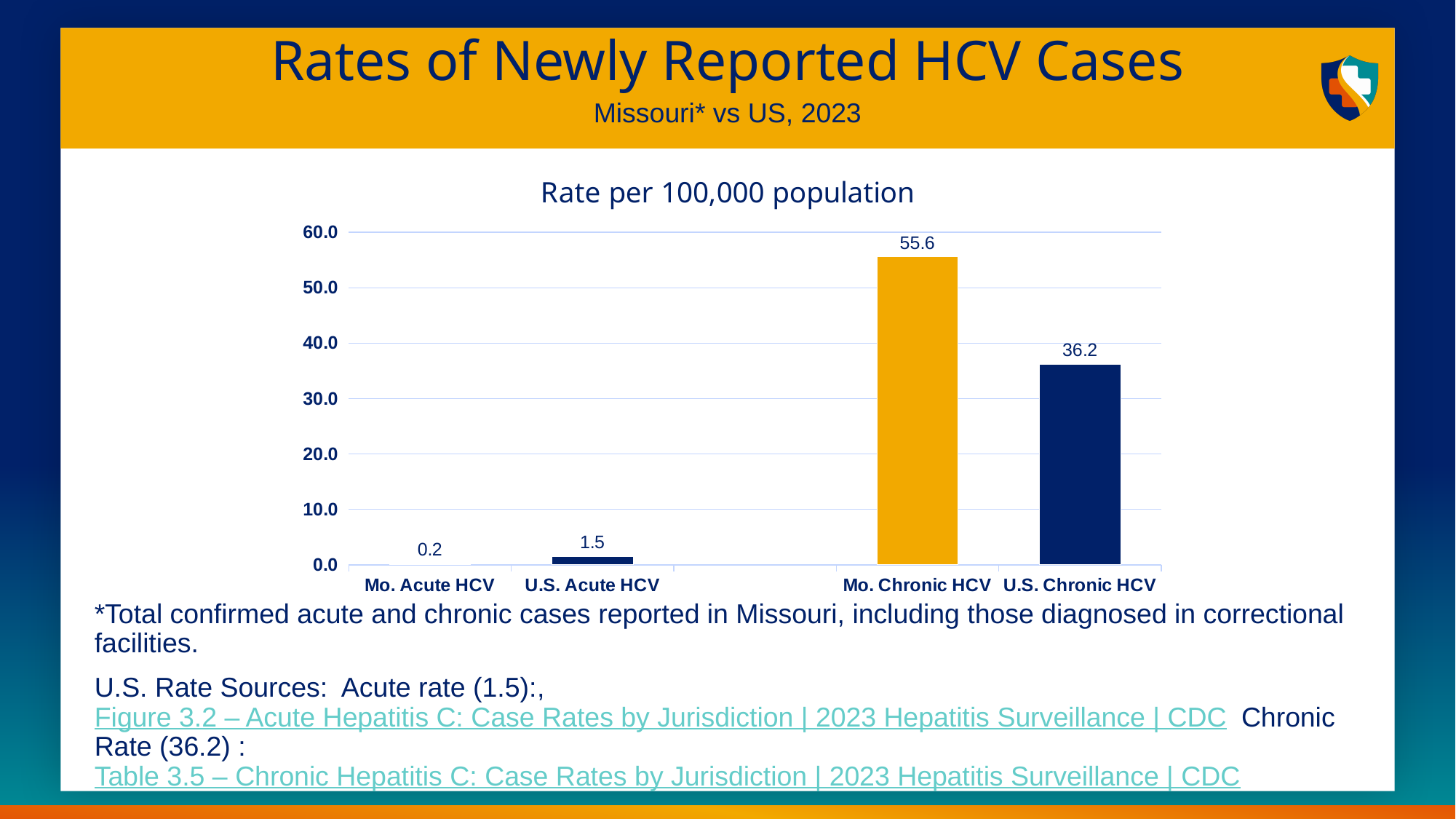
What is the rate for U.S. Acute HCV? 1.5 What kind of chart is shown on the slide? Bar chart What is the difference between the Mo. Chronic HCV rate and the U.S. Chronic HCV rate? 19.4 How many categories are shown on the chart? 4 What is the title of the chart? Rate per 100,000 population Which category has the lowest rate? Mo. Acute HCV What is the rate for Mo. Chronic HCV? 55.6 What is the rate for Mo. Acute HCV? 0.2 Is the value for U.S. Chronic HCV greater or less than 40.0? less Which is larger, the Mo. Acute HCV rate or the U.S. Acute HCV rate? U.S. Acute HCV What is the rate for U.S. Chronic HCV? 36.2 Which category has the highest rate? Mo. Chronic HCV